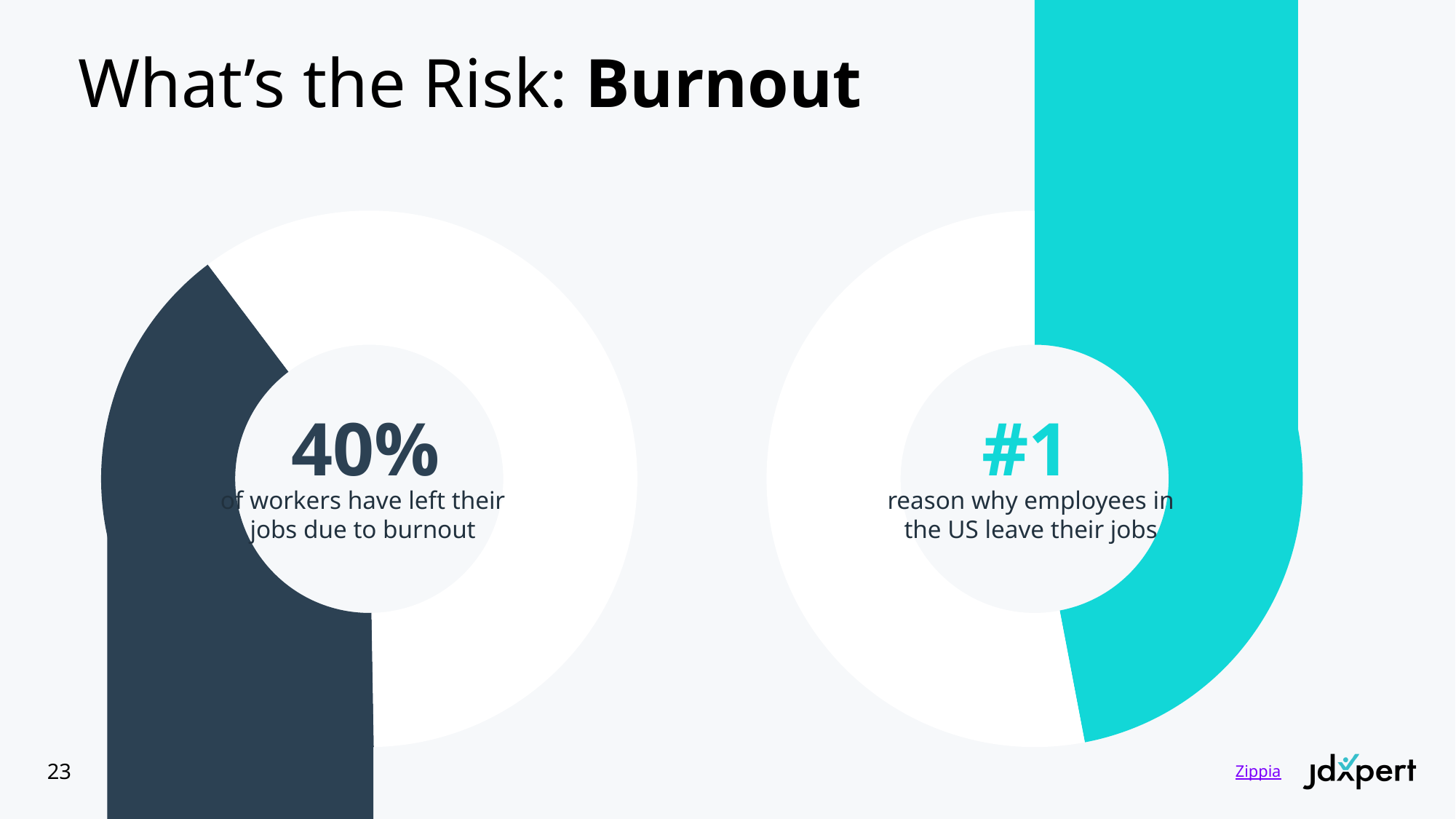
What colour is the filled segment of the left donut chart showing 40%? Dark navy blue What text accompanies the 40% figure in the centre of the left donut chart? of workers have left their jobs due to burnout What text accompanies the #1 figure in the centre of the right donut chart? reason why employees in the US leave their jobs How many donut charts are shown on the slide? 2 What kind of chart is used on the left side of the slide to show the 40% figure? Donut (pie) chart On the right chart, what ranking is given to burnout as a reason why employees in the US leave their jobs? #1 On the left chart, is the share of workers who left their jobs due to burnout greater or less than 50%? less What is the title of the slide containing the two donut charts? What's the Risk: Burnout On the left chart, what percentage of workers have left their jobs due to burnout? 40%